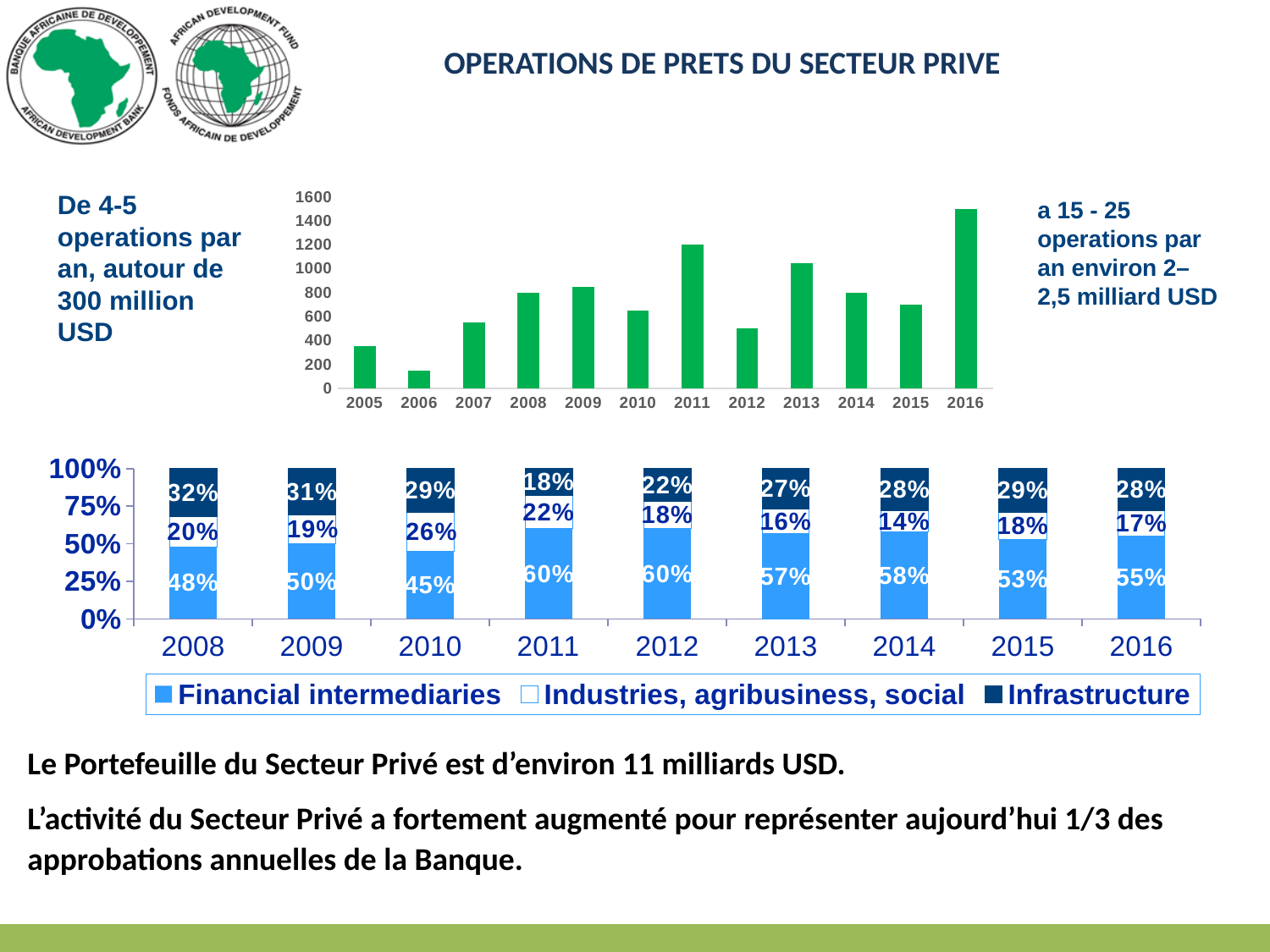
In the bottom stacked chart, what is the difference between the Financial intermediaries share in 2011 and in 2008? 12% In the bottom stacked chart, how many series does the legend list? 3 In the bottom stacked chart, what is the share of Financial intermediaries in 2011? 60% In the top chart (green bars by year), which year has the highest value? 2016 What kind of chart is the bottom chart? Stacked bar chart In the top chart (green bars by year), which is larger, the value for 2013 or the value for 2014? 2013 In the top chart (green bars by year), which year has the lowest value? 2006 In the top chart (green bars by year), is the value for 2012 greater or less than 600? less In the bottom stacked chart, what is the share of Industries, agribusiness, social in 2010? 26% In the top chart (green bars by year), is the value for 2011 greater or less than 1000? greater In the top chart (green bars by year), how many years are shown on the x axis? 12 In the bottom stacked chart, what is the share of Infrastructure in 2008? 32%